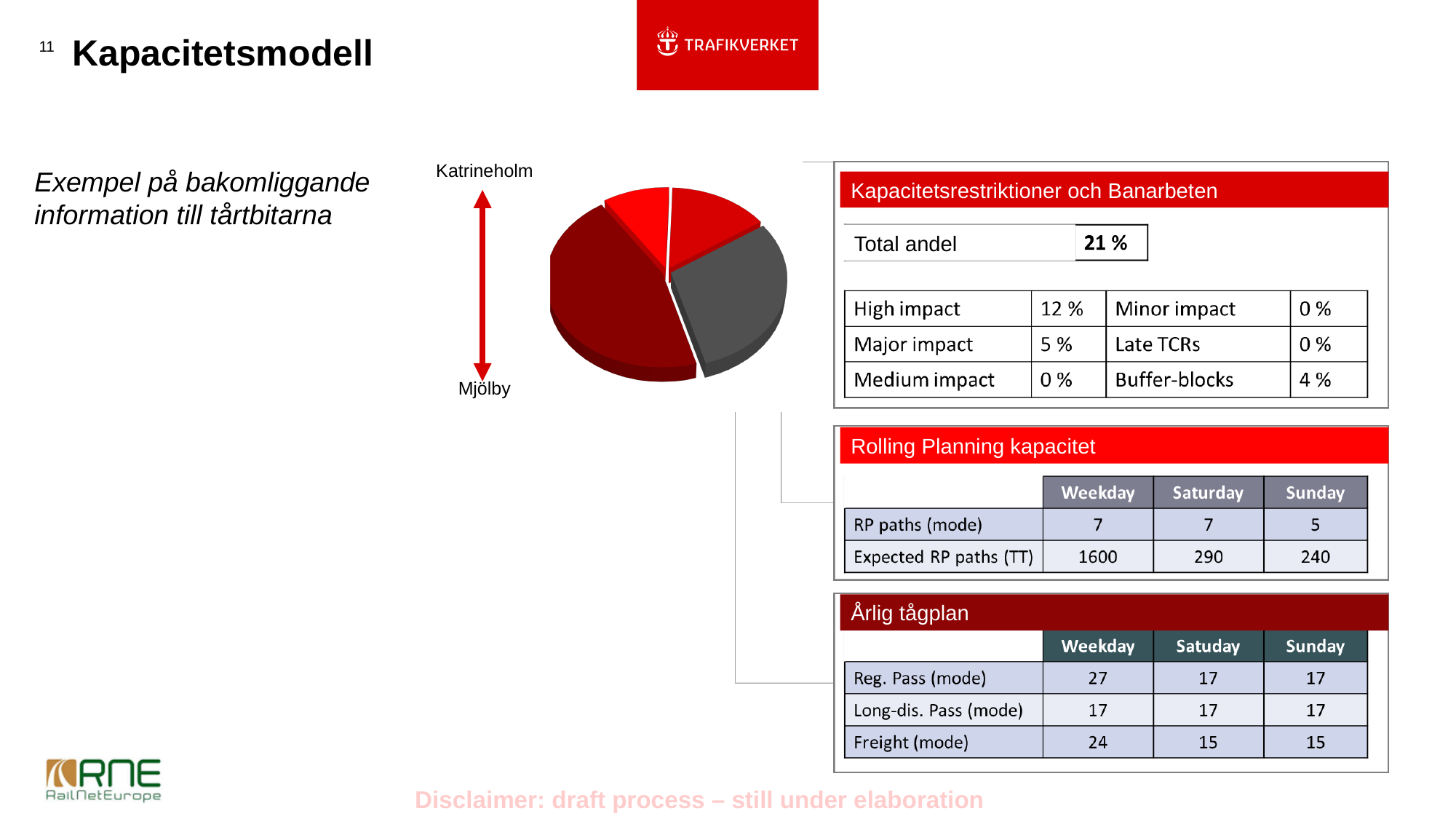
Is the grey slice of the pie chart larger or smaller than the dark red slice? smaller What kind of chart is shown on the slide? pie chart Is the grey slice of the pie chart larger or smaller than the bright red slice at the top left? larger How many slices does the pie chart have? 4 Does the pie chart have a legend? No Which two place names are shown next to the pie chart on the slide? Katrineholm and Mjölby Which slice of the pie chart is the largest? the dark red slice